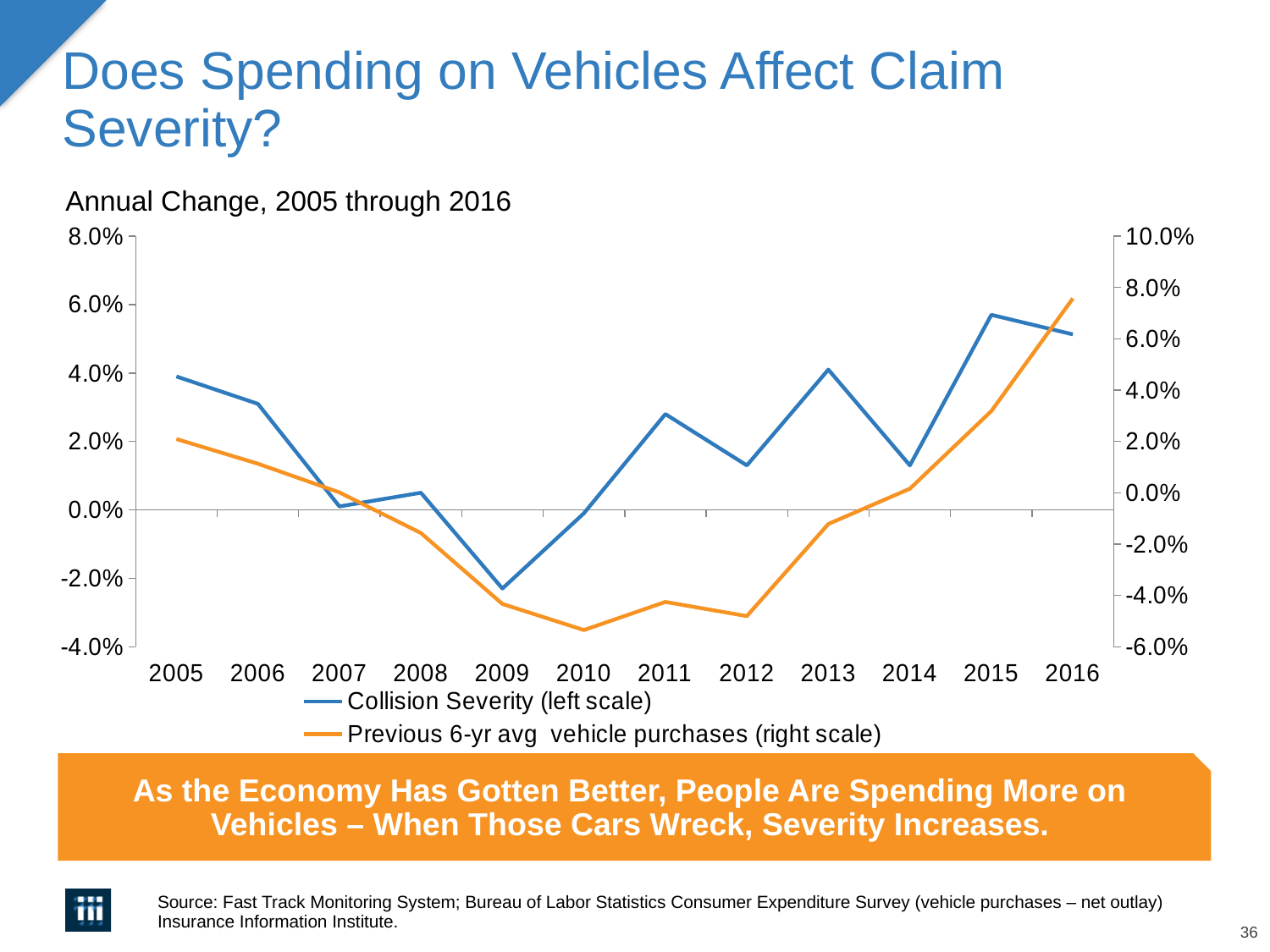
Which series is plotted on the right scale according to the legend? Previous 6-yr avg vehicle purchases In which year does the Previous 6-yr avg vehicle purchases series reach its lowest value? 2010 How many years are plotted along the x axis? 12 In which year does the Previous 6-yr avg vehicle purchases series reach its highest value? 2016 Is the Previous 6-yr avg vehicle purchases value for 2016 greater or less than 6.0% on the right scale? greater In which year does the Collision Severity series reach its highest value? 2015 Which year has the higher Collision Severity value, 2013 or 2014? 2013 In which year does the Collision Severity series reach its lowest value? 2009 Does the Previous 6-yr avg vehicle purchases series rise or fall from 2012 to 2016? Rise How many series does the legend list? 2 Is the Collision Severity value for 2009 greater or less than 0.0%? less What kind of chart is shown on the slide? Line chart